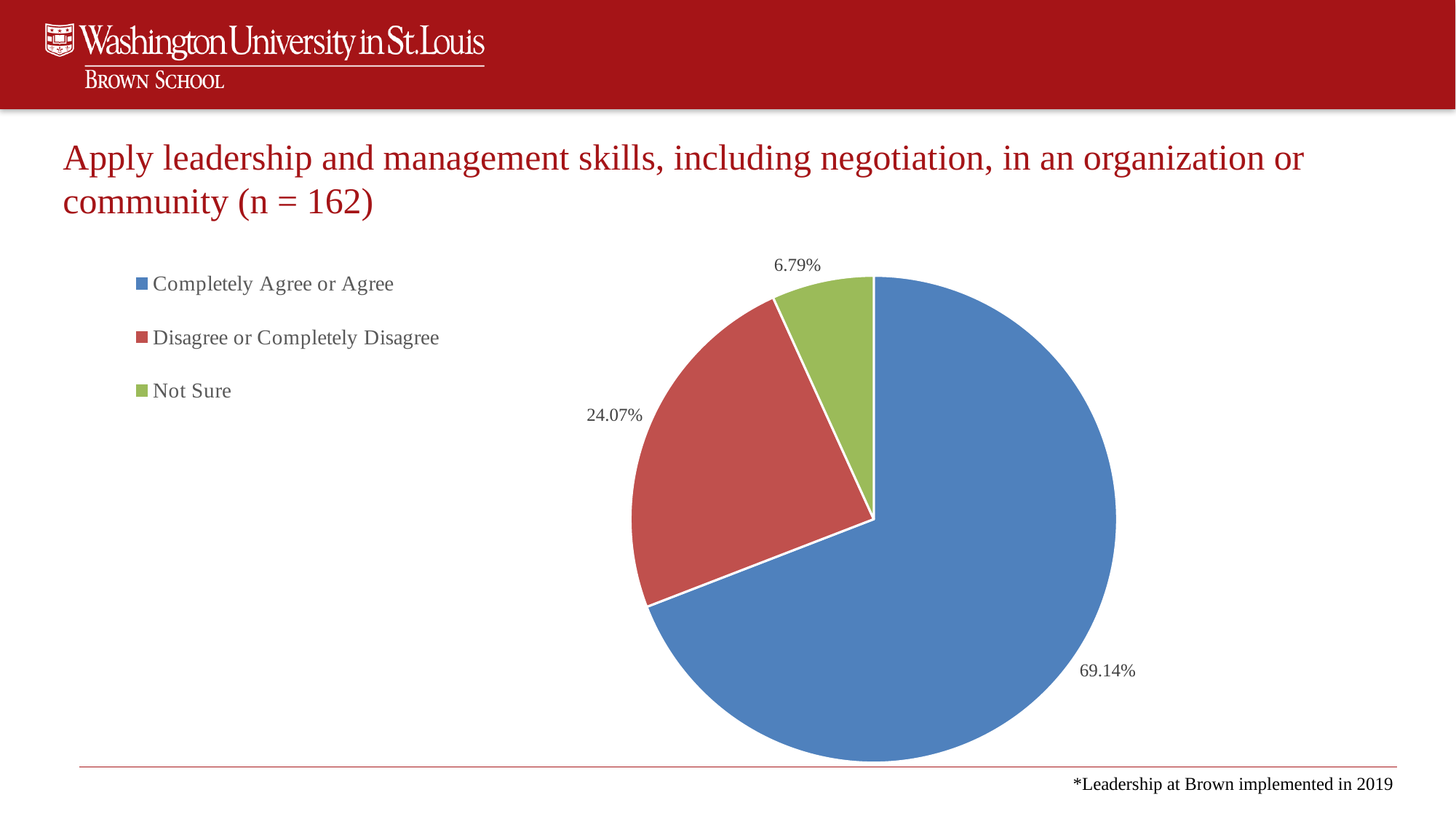
What percentage of respondents answered Completely Agree or Agree? 69.14% Which response category has the smallest share of the pie? Not Sure What is the difference in percentage points between Completely Agree or Agree and Disagree or Completely Disagree? 45.07 How many slices does the pie chart have? 3 What colour is the slice for Not Sure? Green Which is larger: the share for Disagree or Completely Disagree or the share for Not Sure? Disagree or Completely Disagree How many respondents (n) does the slide title report? 162 What kind of chart is shown on the slide? Pie chart What percentage of respondents answered Not Sure? 6.79% What is the difference in percentage points between Disagree or Completely Disagree and Not Sure? 17.28 Which response category has the largest share of the pie? Completely Agree or Agree What percentage of respondents answered Disagree or Completely Disagree? 24.07%